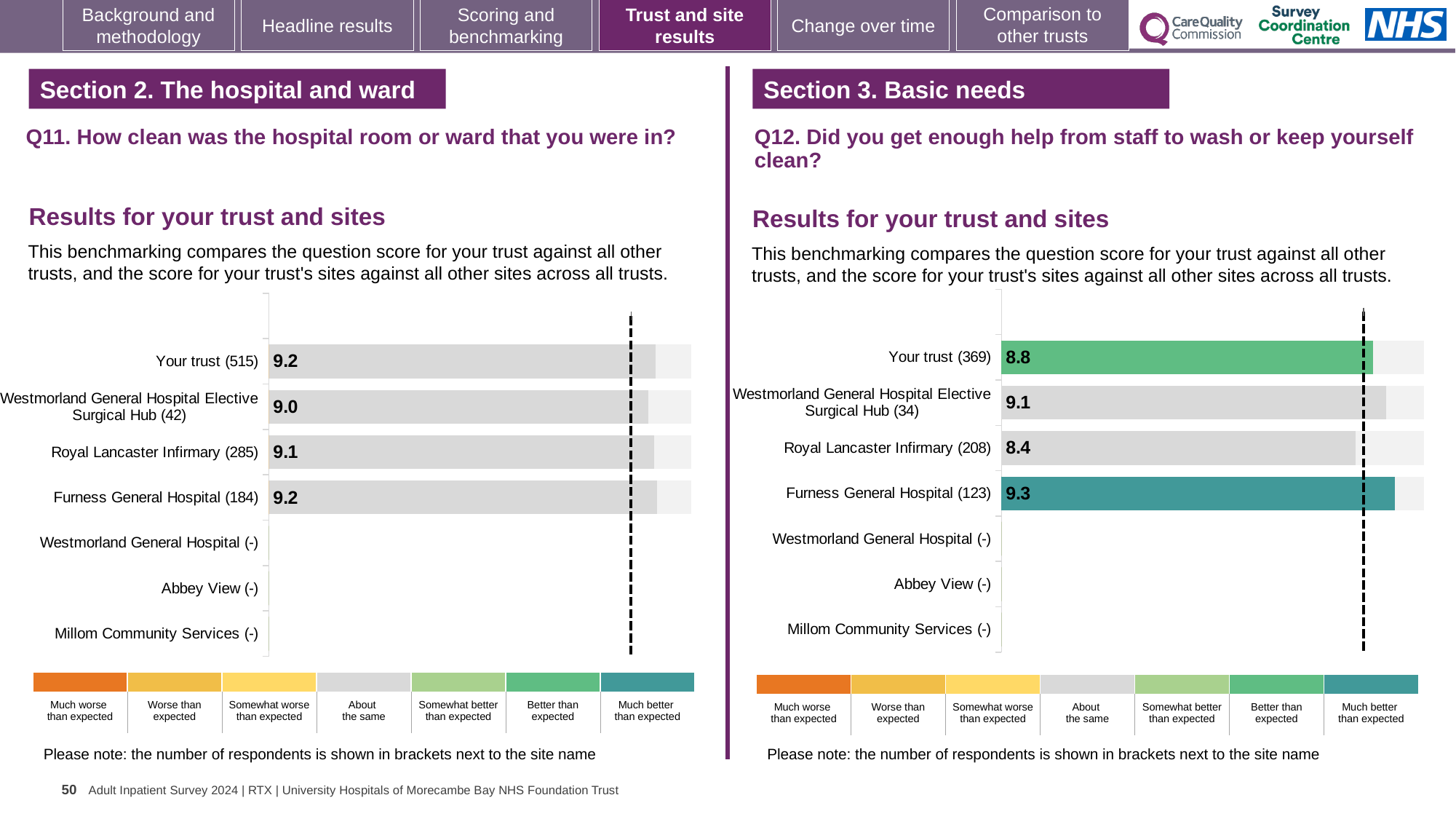
In the Q12 chart on the right, what is the difference between the scores for Furness General Hospital (123) and Royal Lancaster Infirmary (208)? 0.9 In the Q11 chart on the left, which site has the lowest score? Westmorland General Hospital Elective Surgical Hub (42) What kind of chart is used for the Q11 results on the left? Bar chart In the Q11 chart on the left, what is the score for Royal Lancaster Infirmary (285)? 9.1 In the Q12 chart on the right, how many sites have a score bar plotted? 4 In the Q12 chart on the right, which has the higher score: Your trust (369) or Westmorland General Hospital Elective Surgical Hub (34)? Westmorland General Hospital Elective Surgical Hub (34) In the Q12 chart on the right, which site has the highest score? Furness General Hospital (123) In the Q11 chart on the left, what is the difference between the scores for Furness General Hospital (184) and Westmorland General Hospital Elective Surgical Hub (42)? 0.2 In the Q12 chart on the right, which site has the lowest score? Royal Lancaster Infirmary (208) In the Q12 chart on the right, what is the score for Royal Lancaster Infirmary (208)? 8.4 In the Q11 chart on the left, what is the score for Your trust (515)? 9.2 In the Q12 chart on the right, what is the score for Your trust (369)? 8.8